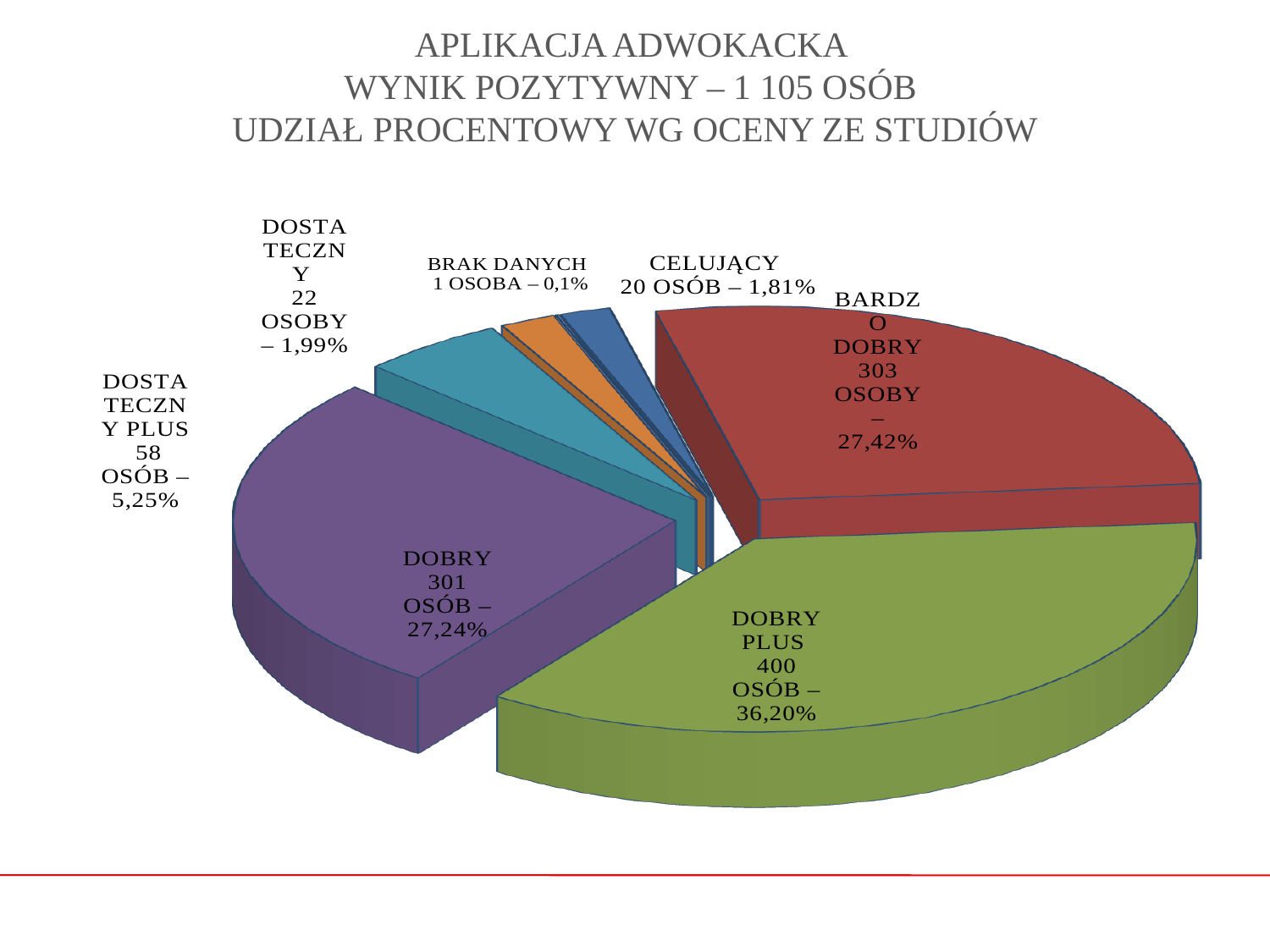
Which category has the largest share of the pie? DOBRY PLUS What percentage is shown for DOSTATECZNY PLUS? 5,25% What is the difference in number of people between DOBRY PLUS (400) and DOBRY (301)? 99 According to the title, how many people in total had a positive result (wynik pozytywny)? 1 105 What percentage share is shown for DOBRY PLUS? 36,20% How many slices does the pie chart have? 7 Which has more people, DOSTATECZNY or CELUJĄCY? DOSTATECZNY Which category has the smallest share of the pie? BRAK DANYCH How many people (osób) are shown for BARDZO DOBRY? 303 What kind of chart is shown on the slide? Pie chart What percentage is shown for BRAK DANYCH? 0,1% How many people are shown for CELUJĄCY? 20